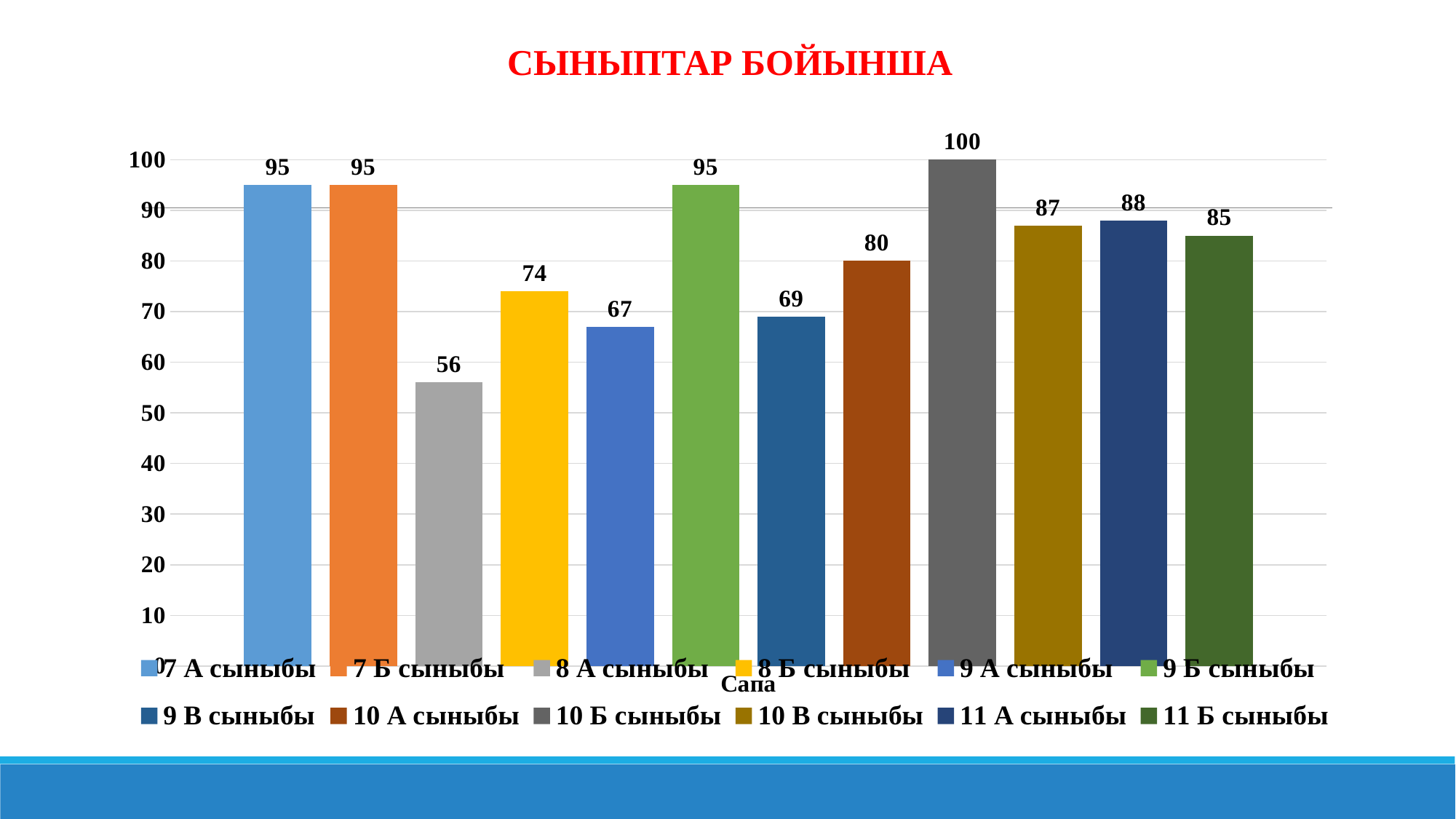
What is the difference between the values for 10 А сыныбы and 8 Б сыныбы? 6 How many series does the legend list? 12 What is the value for 9 В сыныбы? 69 Which series has the highest value? 10 Б сыныбы Which is larger, the value for 10 В сыныбы or the value for 11 Б сыныбы? 10 В сыныбы What is the title of the chart? СЫНЫПТАР БОЙЫНША What is the difference between the values for 10 Б сыныбы and 8 А сыныбы? 44 What is the value for 8 А сыныбы? 56 Which series has the lowest value? 8 А сыныбы What kind of chart is shown on the slide? Bar chart What is the value for 10 Б сыныбы? 100 What is the value for 11 А сыныбы? 88